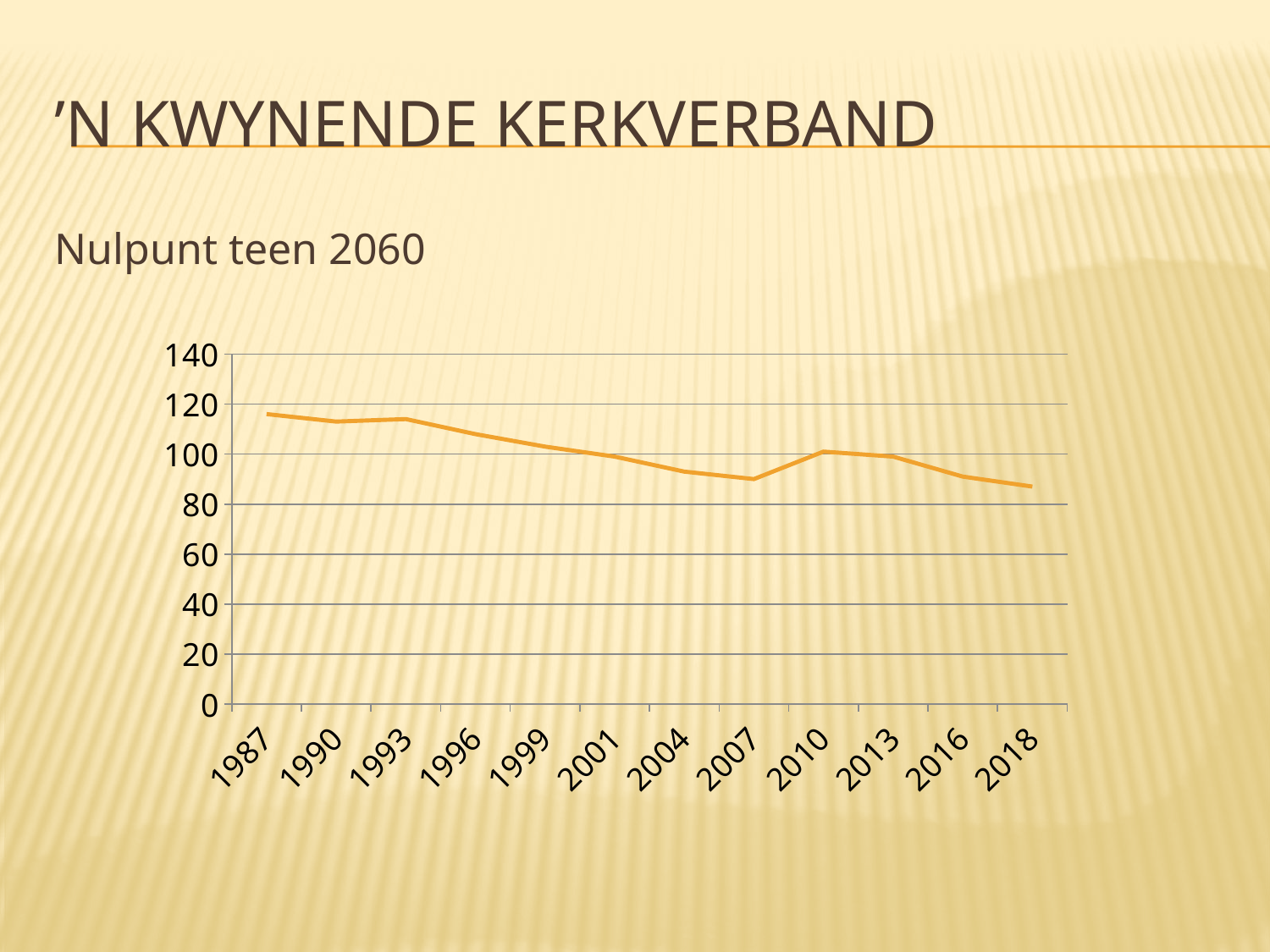
Is the value for 1996 greater or less than 100? greater Is the value for 2018 greater or less than 80? greater Which year has the larger value, 2007 or 2010? 2010 How many years are labelled along the x axis of the chart? 12 Is the value for 2018 greater or less than 100? less Do the values generally rise or fall from 1987 to 2018? fall What is the highest value shown on the y axis of the chart? 140 What kind of chart is shown on the slide? line chart Which year has the larger value, 1987 or 2018? 1987